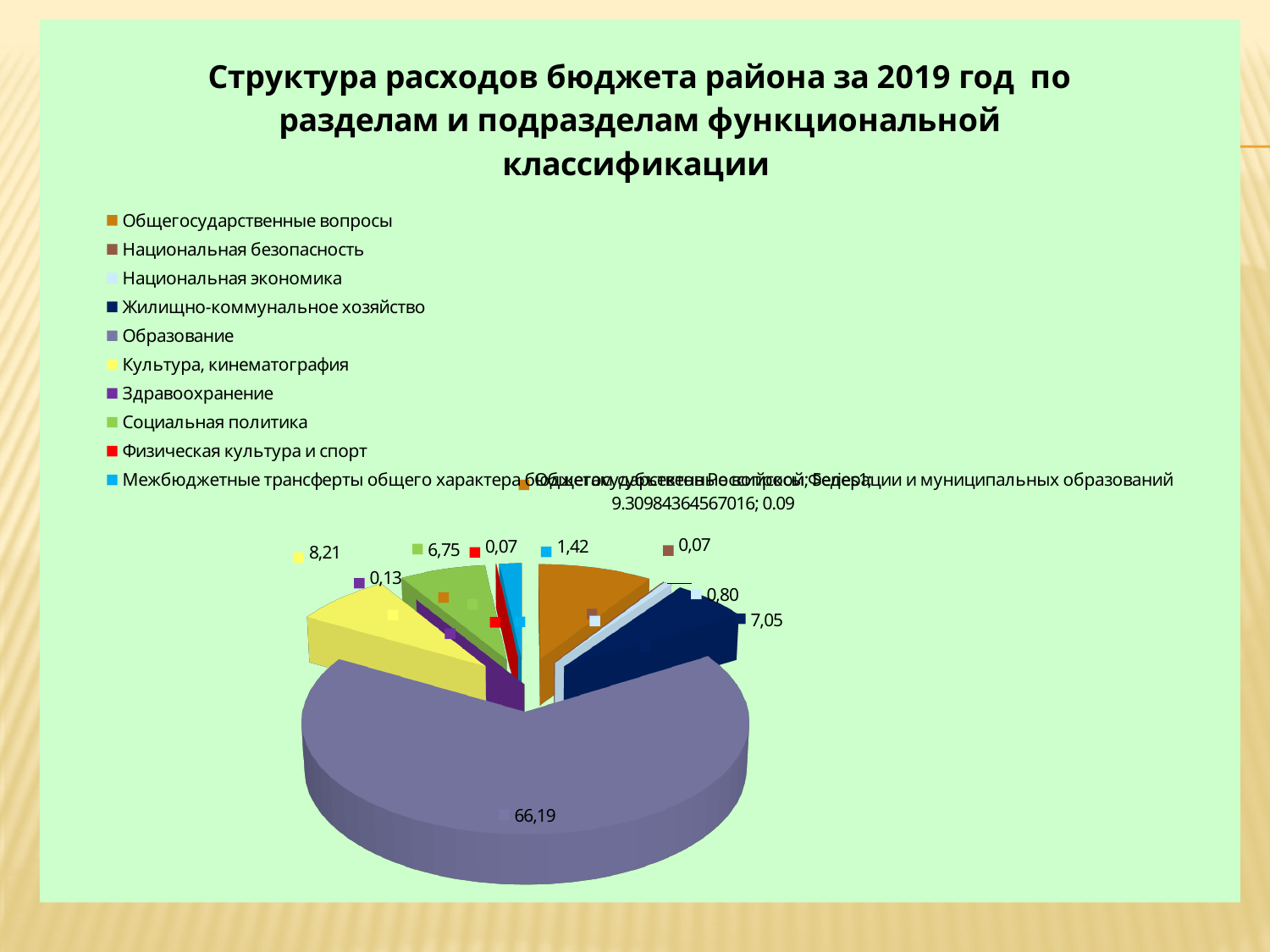
What colour is the slice for Образование in the pie chart? grey-purple What is the difference between the values for Культура, кинематография and Жилищно-коммунальное хозяйство in the pie chart? 1,16 What is the value shown for Жилищно-коммунальное хозяйство in the pie chart? 7,05 What is the value shown for Социальная политика in the pie chart? 6,75 What kind of chart is shown on the slide? pie chart What is the value shown for Образование in the pie chart? 66,19 Which category has the largest slice in the pie chart? Образование How many categories does the legend of the pie chart list? 10 What is the value shown for Национальная экономика in the pie chart? 0,80 What is the value shown for Культура, кинематография in the pie chart? 8,21 Which is larger in the pie chart, Культура, кинематография or Социальная политика? Культура, кинематография What is the value shown for Здравоохранение in the pie chart? 0,13